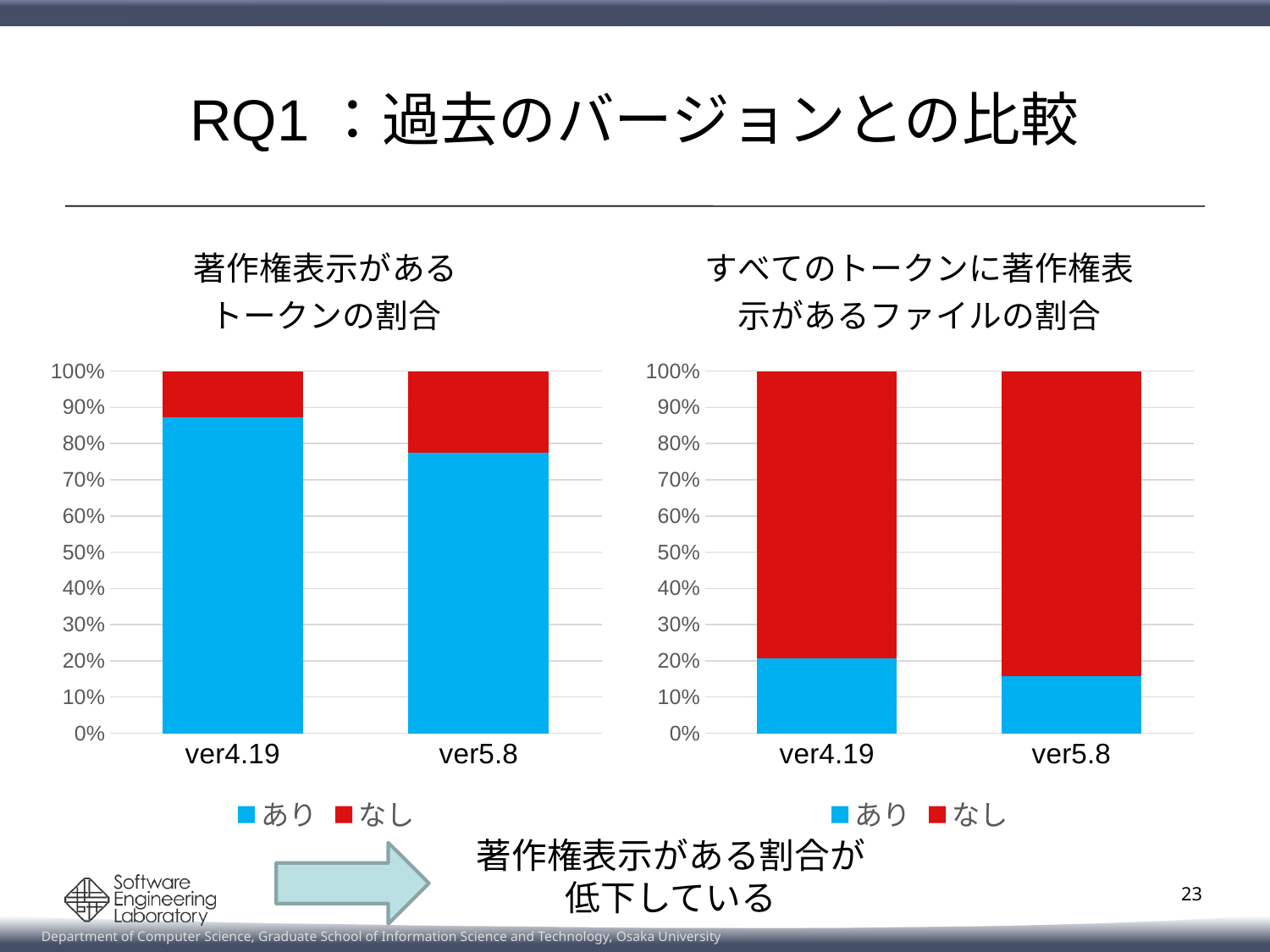
In the right chart (すべてのトークンに著作権表示があるファイルの割合), how many series does the legend list? 2 What kind of chart is the left chart titled 著作権表示があるトークンの割合? stacked bar chart In the left chart (著作権表示があるトークンの割合), is the あり value for ver4.19 greater or less than 80%? greater In the left chart (著作権表示があるトークンの割合), is the あり value for ver5.8 greater or less than 80%? less In the left chart (著作権表示があるトークンの割合), what is the total height of the stacked bar for ver4.19? 100% In the left chart (著作権表示があるトークンの割合), how many categories are shown on the x axis? 2 In the right chart (すべてのトークンに著作権表示があるファイルの割合), is the あり value for ver5.8 greater or less than 10%? greater What are the two legend entries of the left chart (著作権表示があるトークンの割合)? あり, なし In the left chart (著作権表示があるトークンの割合), which version has the larger あり share, ver4.19 or ver5.8? ver4.19 In the right chart (すべてのトークンに著作権表示があるファイルの割合), does the あり share rise or fall from ver4.19 to ver5.8? fall In the right chart (すべてのトークンに著作権表示があるファイルの割合), which version has the larger なし share, ver4.19 or ver5.8? ver5.8